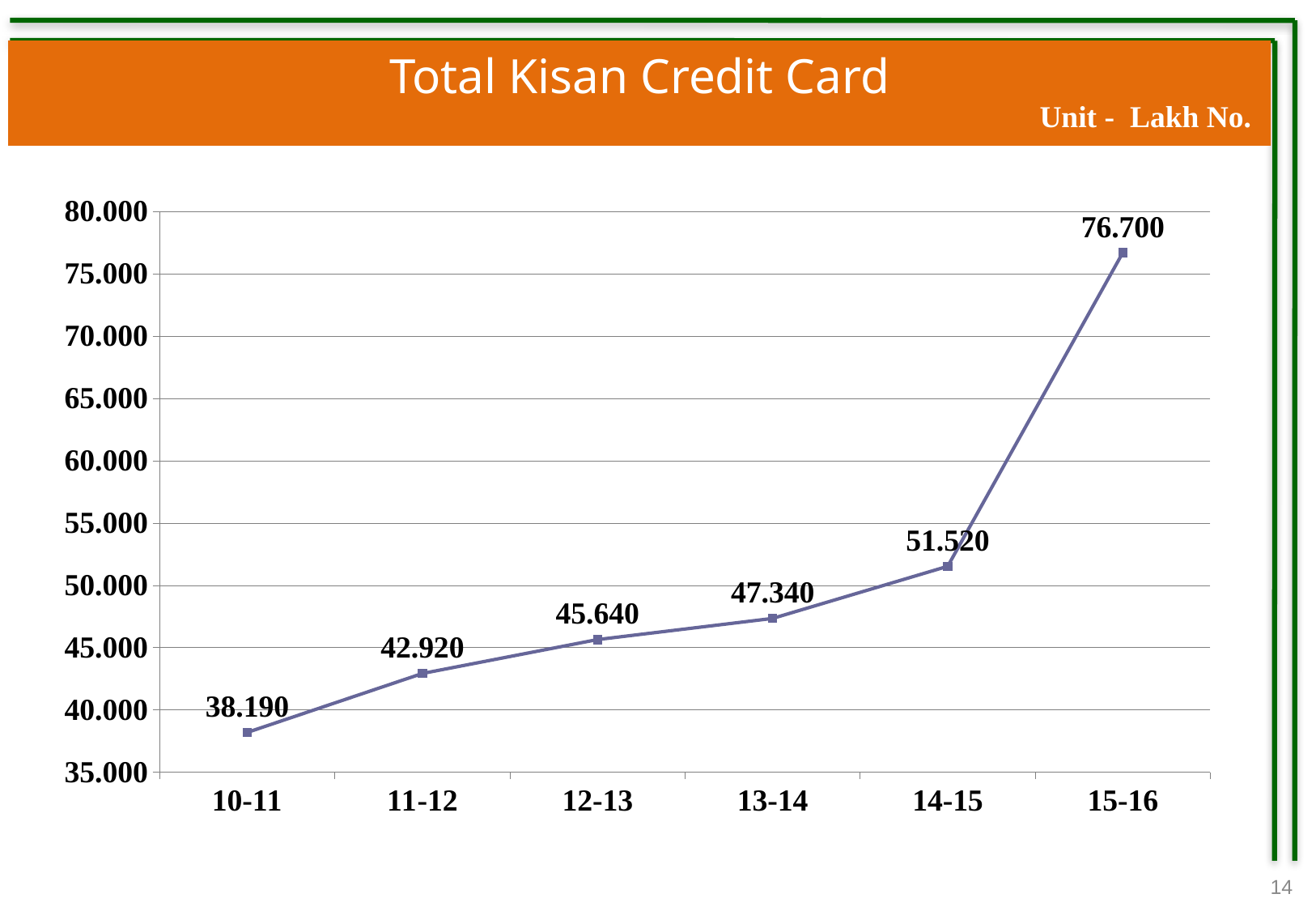
What is the value for 10-11? 38.190 What is the difference between the values for 15-16 and 14-15? 25.180 Do the values rise or fall from 10-11 to 15-16? rise What is the value for 13-14? 47.340 Which is larger, the value for 12-13 or the value for 13-14? 13-14 How many years are plotted on the chart? 6 Is the value for 14-15 greater or less than 50.000? greater What kind of chart is this? line chart Which year has the lowest value? 10-11 Which year has the highest value? 15-16 What is the difference between the values for 11-12 and 10-11? 4.730 What is the value for 15-16? 76.700